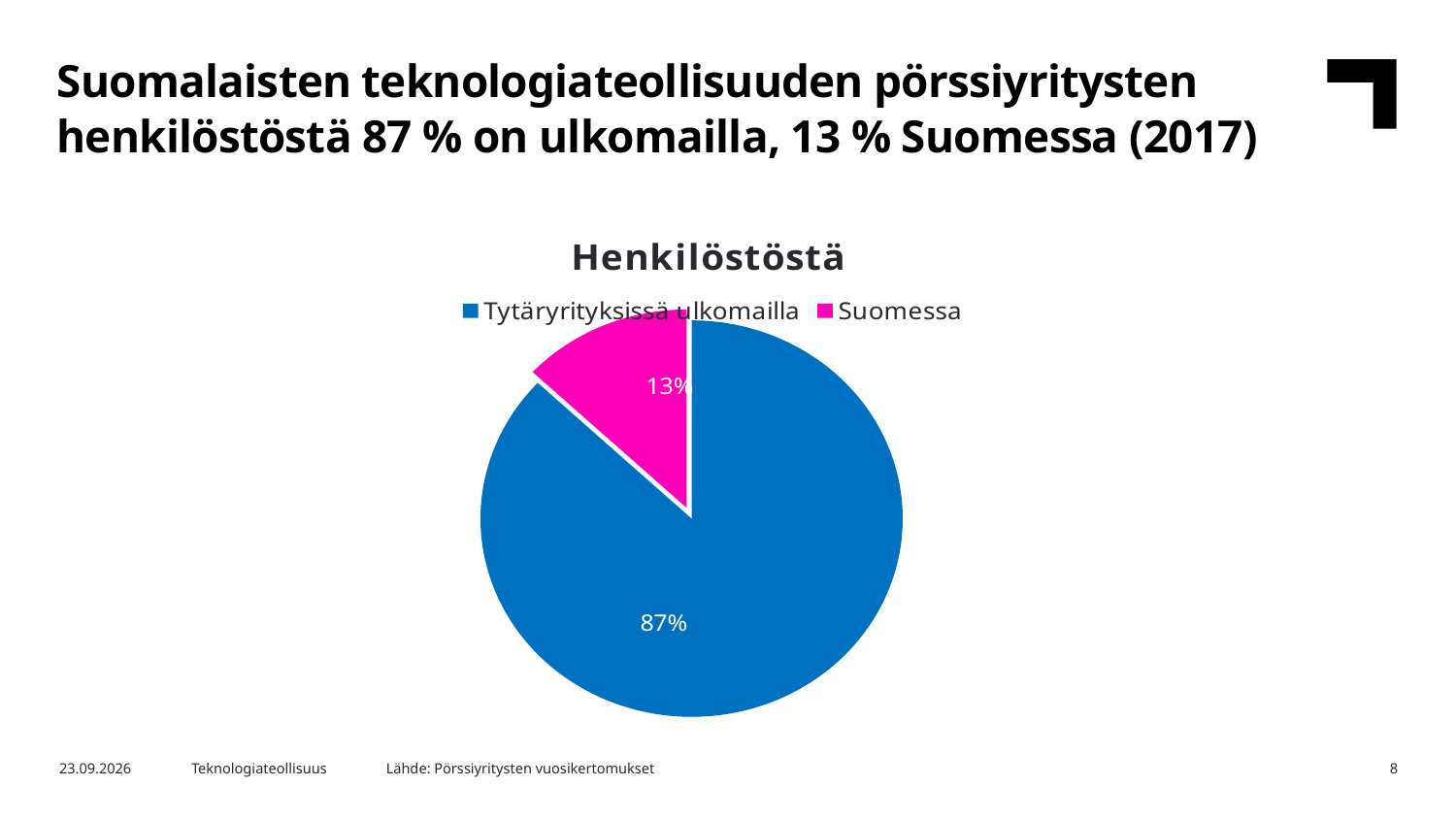
Which is larger, the "Suomessa" slice or the "Tytäryrityksissä ulkomailla" slice? Tytäryrityksissä ulkomailla Which slice of the pie is the largest? Tytäryrityksissä ulkomailla What kind of chart is shown on the slide? pie chart What is the title of the chart? Henkilöstöstä Which slice of the pie is the smallest? Suomessa How many slices does the pie chart have? 2 What share of the pie does "Suomessa" represent? 13% How many entries does the legend list? 2 What share of the pie does "Tytäryrityksissä ulkomailla" represent? 87% What colour is the "Suomessa" slice? magenta (pink) What is the difference in percentage points between the "Tytäryrityksissä ulkomailla" slice and the "Suomessa" slice? 74 percentage points